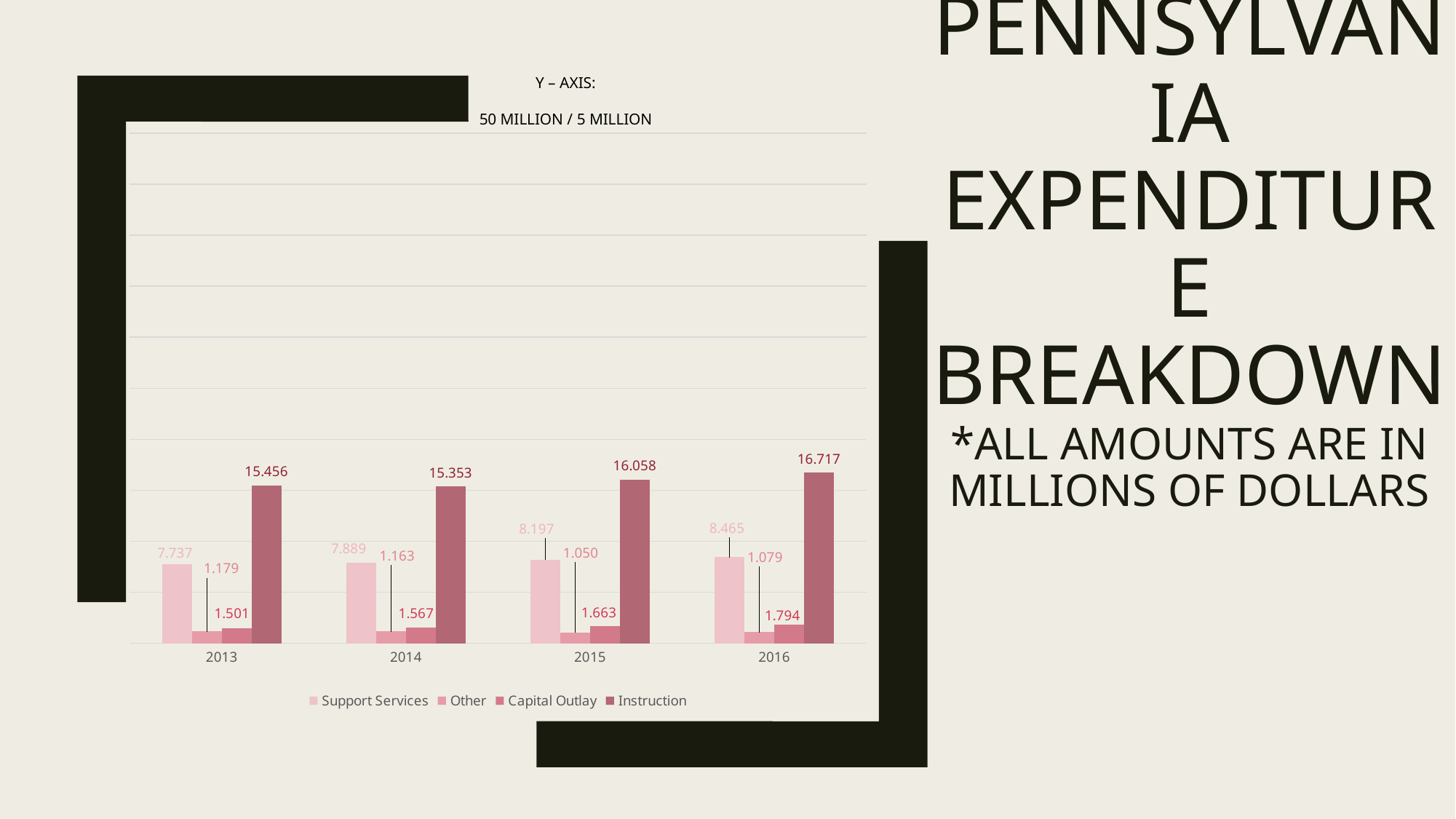
How many series does the legend list? 4 In which year is the Other value lowest? 2015 In which year is the Instruction value highest? 2016 Do the Support Services values rise or fall from 2013 to 2016? Rise How many years are shown on the x axis? 4 Which is larger, Support Services in 2016 or Support Services in 2014? Support Services in 2016 What is the value for Capital Outlay in 2015? 1.663 What kind of chart is shown on the slide? Bar chart What is the difference between the Instruction values for 2016 and 2013? 1.261 What is the value for Support Services in 2013? 7.737 What is the value for Other in 2014? 1.163 What is the value for Instruction in 2016? 16.717